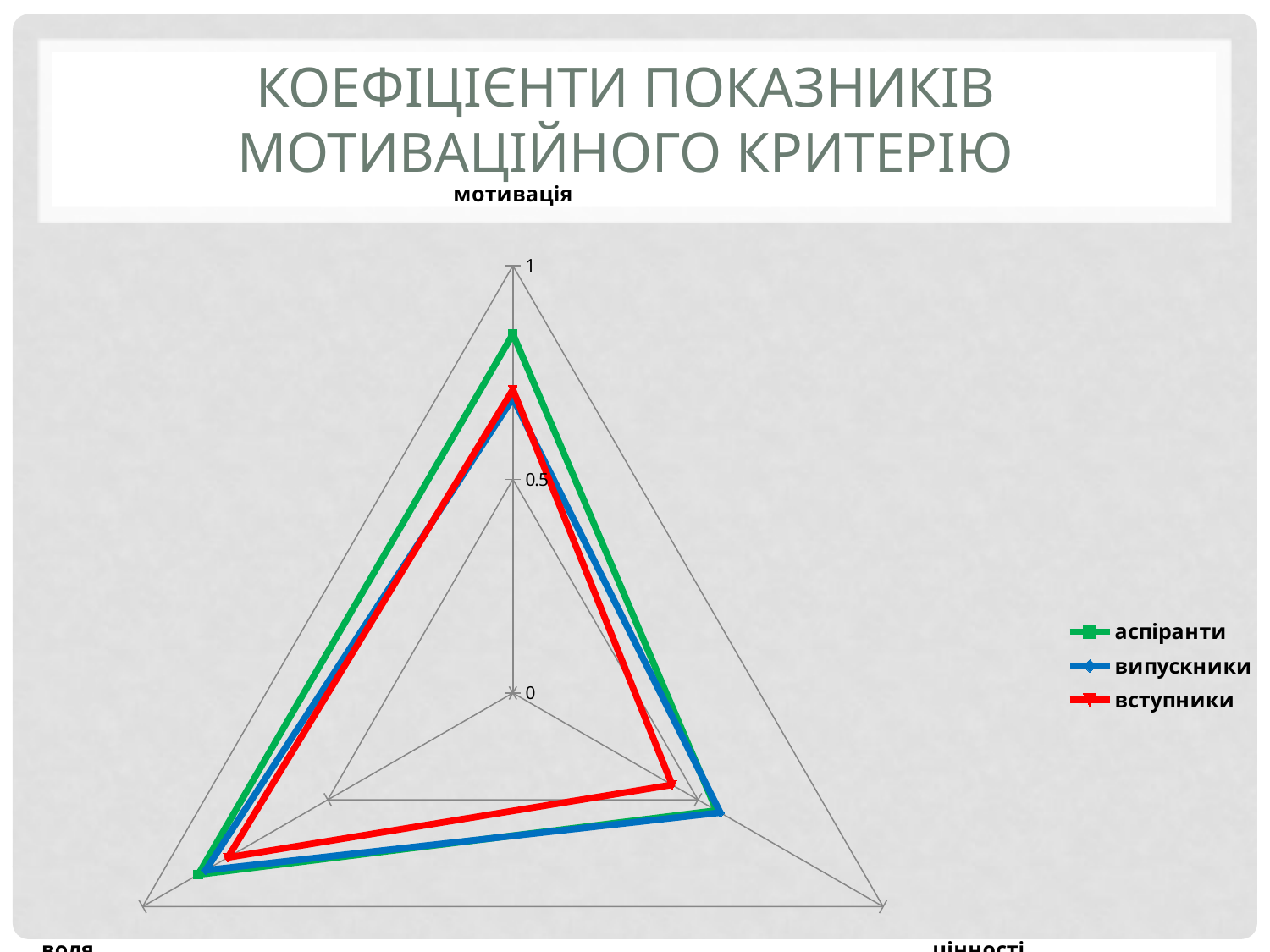
For аспіранти, which is larger: the value on the мотивація axis or the value on the цінності axis? мотивація How many series does the legend list? 3 Which colour is used for the випускники series? blue Which series has the lowest value on the воля axis? вступники For вступники, which is larger: the value on the воля axis or the value on the цінності axis? воля What kind of chart is shown on the slide? radar chart Is the value for вступники on the воля axis greater or less than 0.5? greater Is the value for аспіранти on the мотивація axis greater or less than 0.5? greater Is the value for вступники on the мотивація axis greater or less than 0.5? greater Which series has the highest value on the мотивація axis? аспіранти How many axes (categories) does the radar chart have? 3 Which series has the lowest value on the цінності axis? вступники